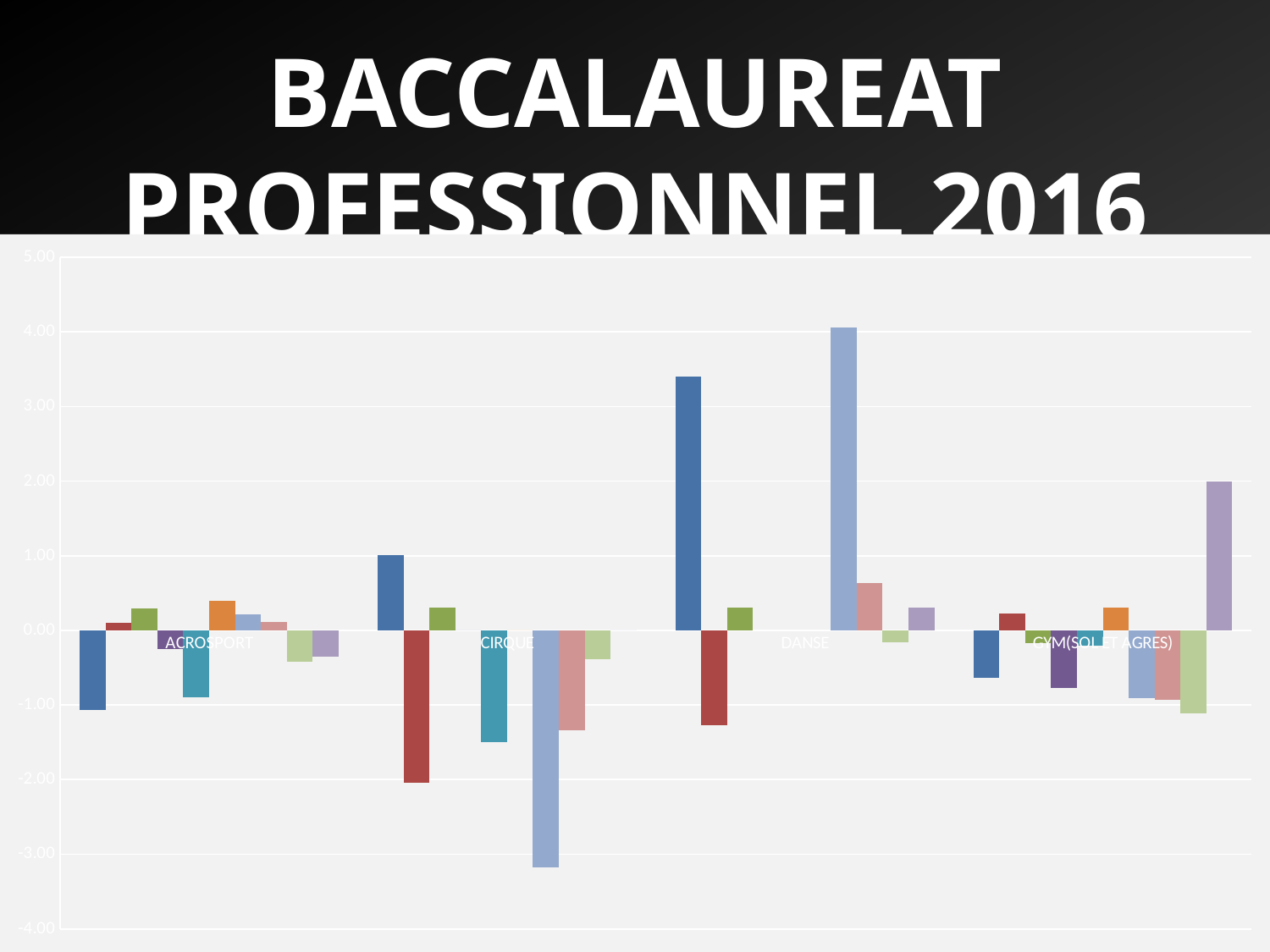
Is the lowest bar in the CIRQUE category greater or less than -3.00? less Which category contains the tallest positive bar in the chart? DANSE How many categories are shown on the x axis of the chart? 4 Is the dark blue bar in the DANSE category greater or less than 3.00? greater Is the lavender bar in the GYM(SOL ET AGRES) category greater or less than 1.00? greater What kind of chart is shown on the slide? bar chart What is the title of the slide containing the chart? BACCALAUREAT PROFESSIONNEL 2016 Which category contains the lowest negative bar in the chart? CIRQUE Which is larger, the dark blue bar for DANSE or the dark blue bar for CIRQUE? DANSE